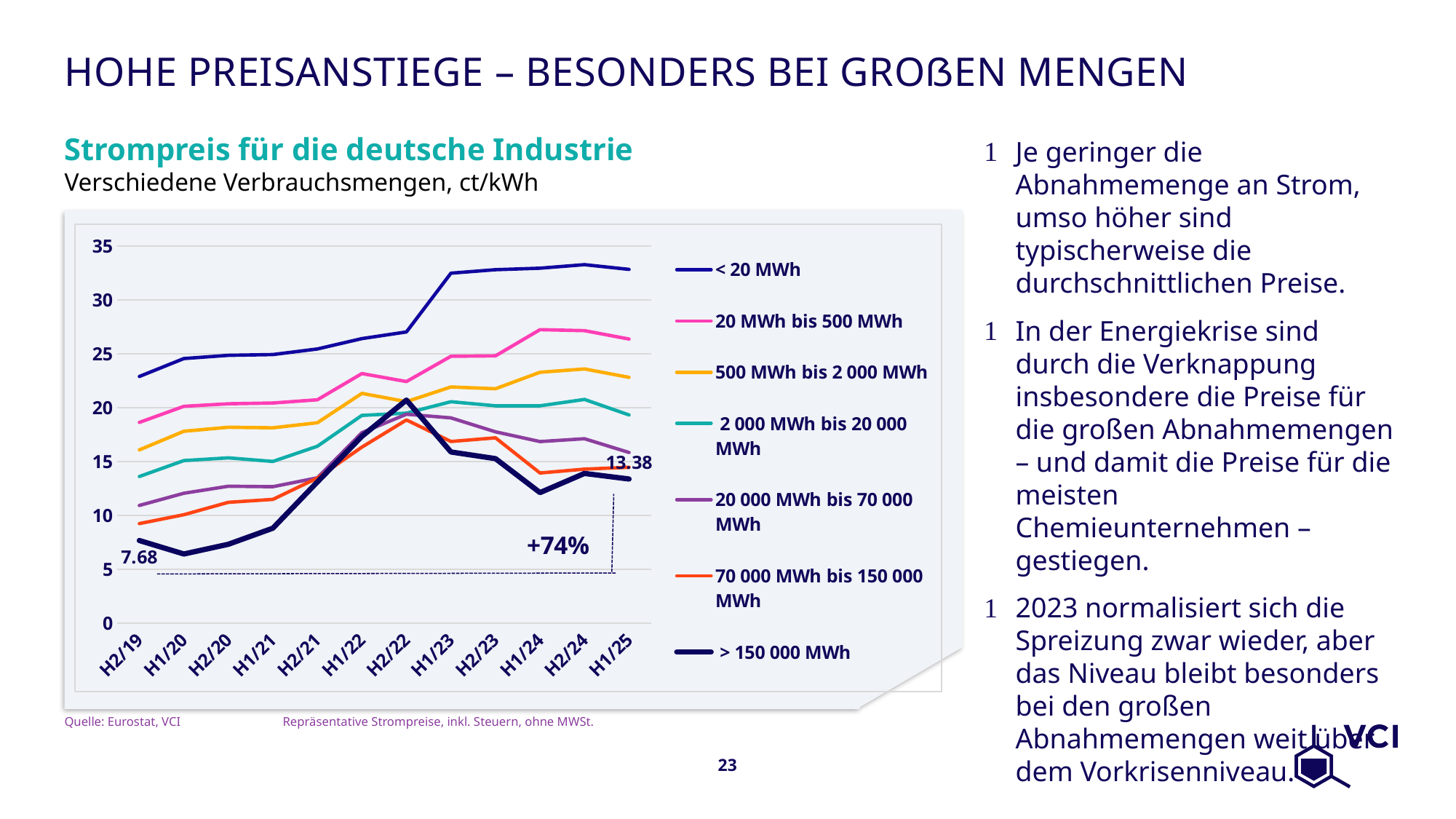
What kind of chart is shown on the slide? line chart What is the value for > 150 000 MWh in H1/25? 13.38 By how much did the value for > 150 000 MWh increase from H2/19 to H1/25? 5.70 How many series does the legend of the chart list? 7 Is the value for > 150 000 MWh in H1/20 greater or less than 10? less In H1/25, which is larger: 20 MWh bis 500 MWh or 500 MWh bis 2 000 MWh? 20 MWh bis 500 MWh Which series has the lowest value in H2/19? > 150 000 MWh Which series has the highest value in H1/25? < 20 MWh What is the value for > 150 000 MWh in H2/19? 7.68 How many time periods are shown on the x axis of the chart? 12 What percentage change is annotated on the chart for the > 150 000 MWh series? +74% Is the value for < 20 MWh in H1/25 greater or less than 30? greater